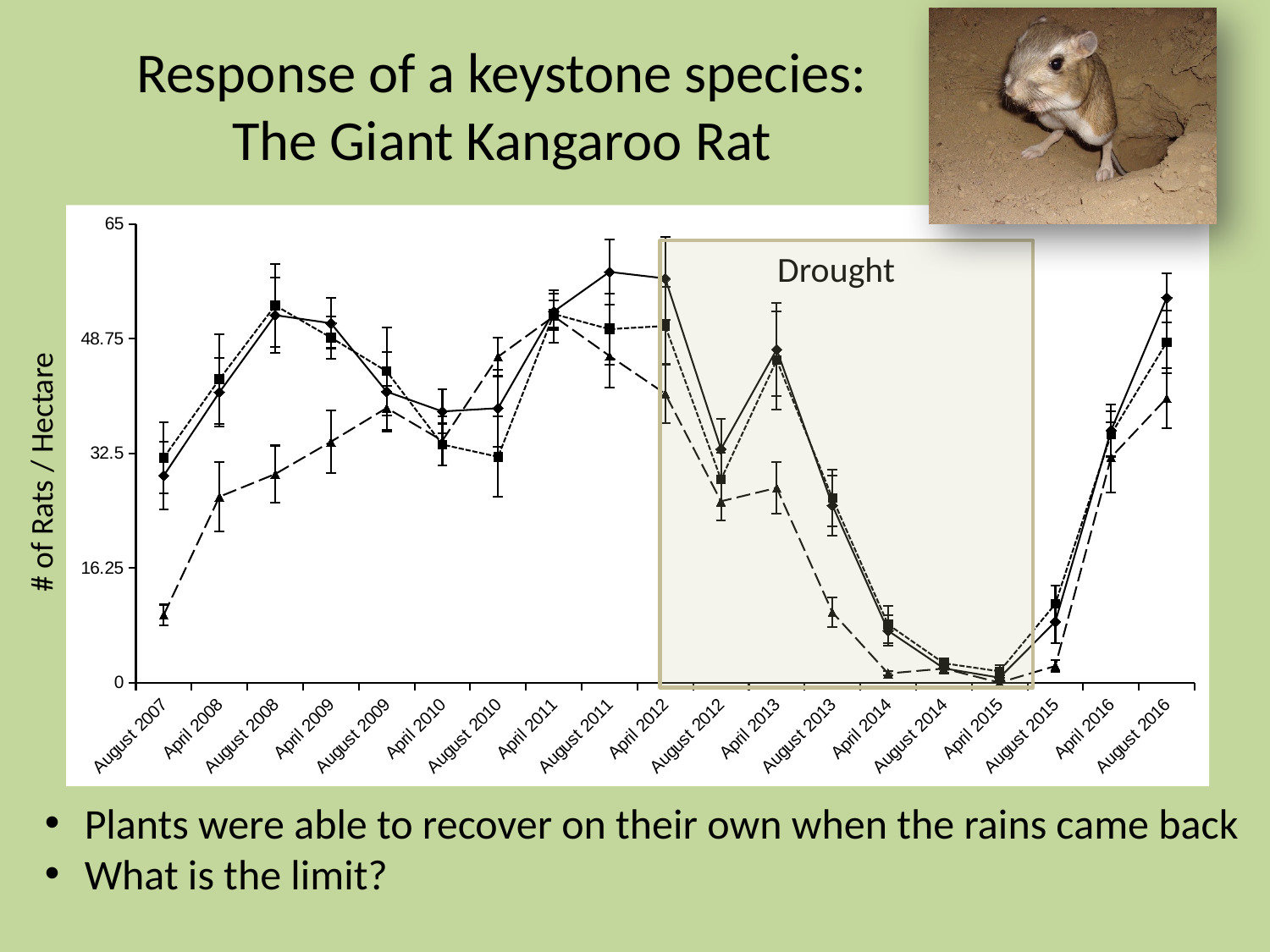
How many time points are labelled along the x axis of the chart? 19 Do the values of the diamond (solid) series rise or fall from April 2015 to August 2016? rise Is the value of the triangle (dashed) series at August 2007 greater or less than 16.25? less Is the value of the square (dotted) series at April 2015 greater or less than 16.25? less What is the label on the y axis of the chart? # of Rats / Hectare Is the value of the diamond (solid) series at August 2016 greater or less than 48.75? greater What label is written inside the shaded box on the chart? Drought What kind of chart is shown on the slide? line chart How many lines (series) are plotted on the chart? 3 Do the values of the diamond (solid) series rise or fall from April 2012 to April 2015? fall